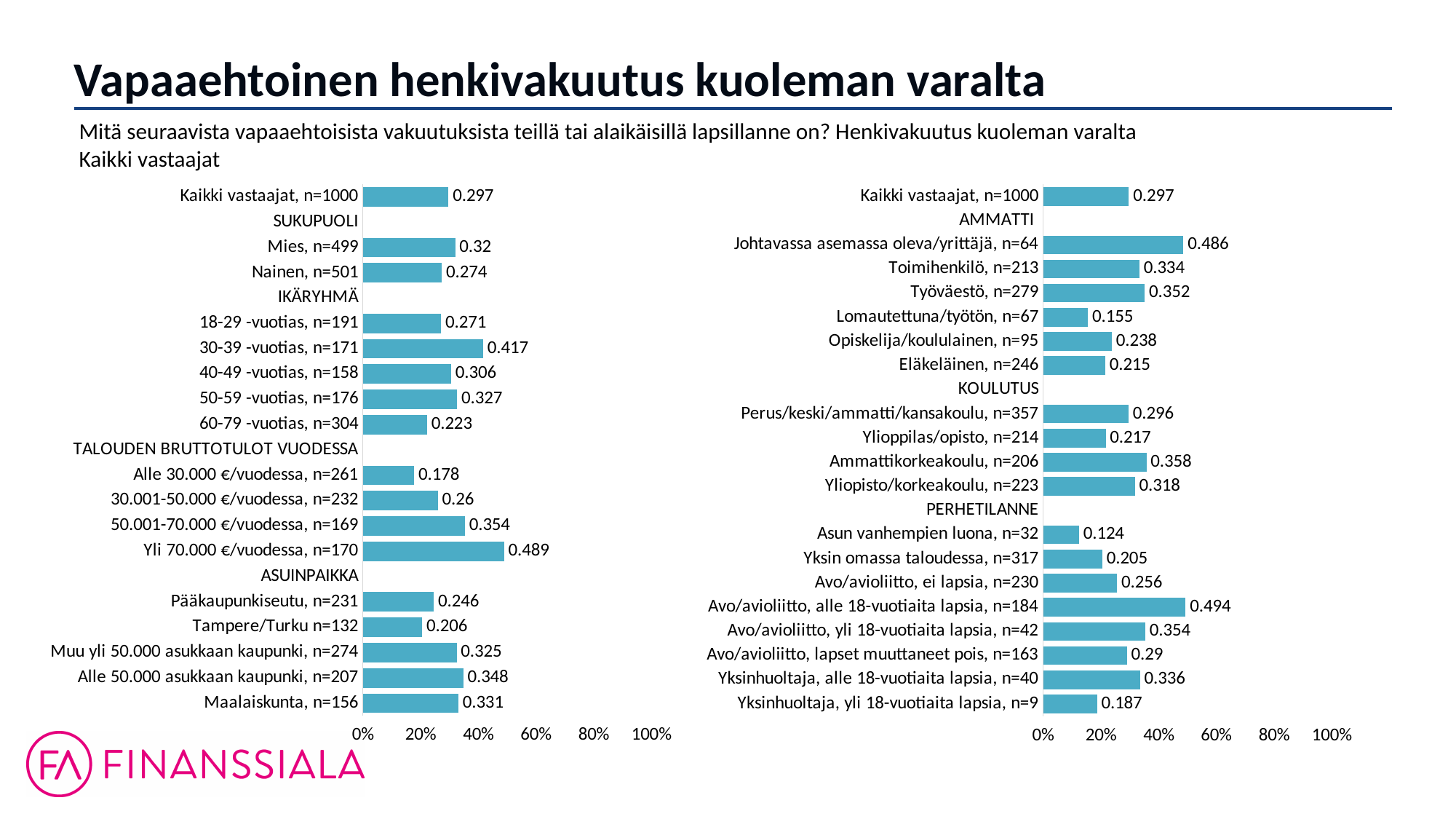
In the right chart, what is the value for Lomautettuna/työtön, n=67? 0.155 What kind of chart is shown on the left of the slide? Bar chart In the right chart, which category has the lowest value? Asun vanhempien luona, n=32 In the left chart, what is the value for 30-39 -vuotias, n=171? 0.417 In the left chart, is the value for Yli 70.000 €/vuodessa, n=170 greater or less than 40%? greater In the right chart, which category has the highest value? Avo/avioliitto, alle 18-vuotiaita lapsia, n=184 In the left chart, what is the difference between the values for Mies, n=499 and Nainen, n=501? 0.046 In the right chart, what is the value for Ammattikorkeakoulu, n=206? 0.358 In the left chart, which category has the highest value? Yli 70.000 €/vuodessa, n=170 In the left chart, what is the value for Mies, n=499? 0.32 In the right chart, which is larger: the value for Toimihenkilö, n=213 or Työväestö, n=279? Työväestö, n=279 In the left chart, which category has the lowest value? Alle 30.000 €/vuodessa, n=261